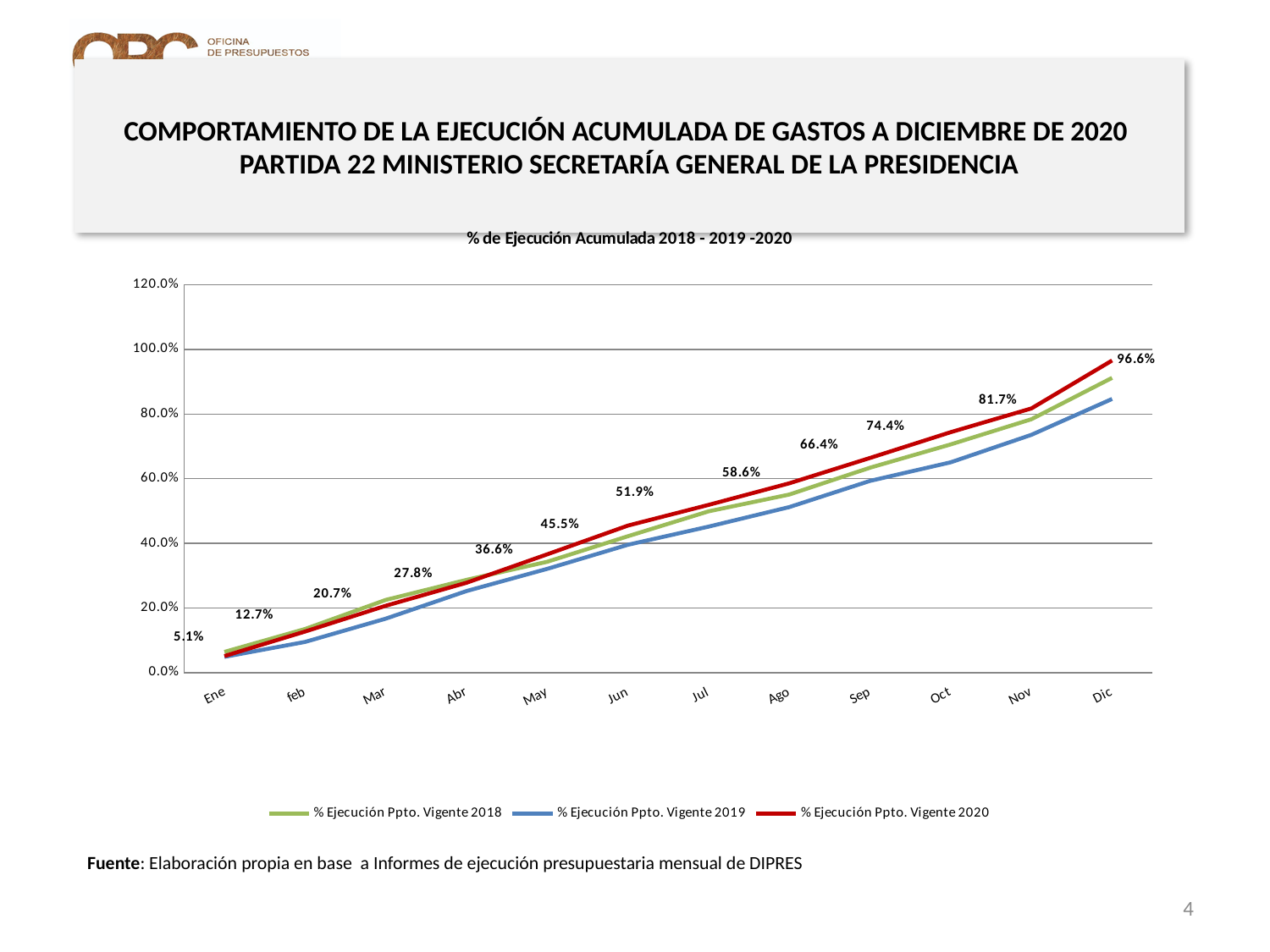
What is the value for % Ejecución Ppto. Vigente 2020 in Jun? 45.5% What kind of chart is shown on the slide? line chart What is the value for % Ejecución Ppto. Vigente 2020 in Dic? 96.6% What is the value for % Ejecución Ppto. Vigente 2020 in Ene? 5.1% How many series does the legend list? 3 Is the value for % Ejecución Ppto. Vigente 2019 in Dic greater or less than 100.0%? less What is the difference between the % Ejecución Ppto. Vigente 2020 values for Dic and Nov? 14.9% How many months are plotted along the x axis? 12 In which month is the % Ejecución Ppto. Vigente 2020 series highest? Dic Do the values of the % Ejecución Ppto. Vigente 2020 series rise or fall from Ene to Dic? rise What is the value for % Ejecución Ppto. Vigente 2020 in Sep? 66.4% What is the title of the chart? % de Ejecución Acumulada 2018 - 2019 -2020